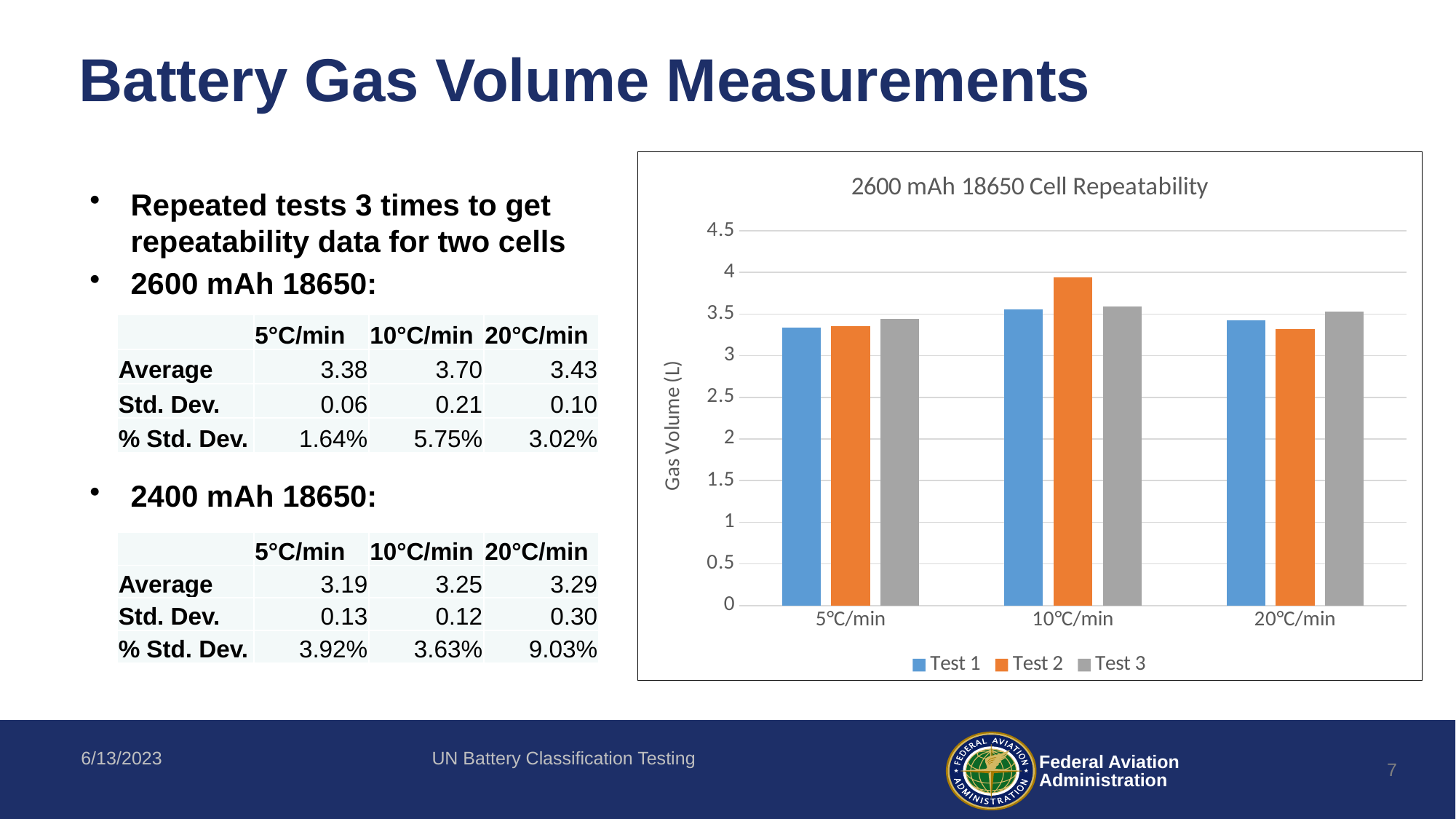
Is the Test 2 value at 20°C/min greater or less than 3.5? less Is the Test 1 value at 5°C/min greater or less than 3.5? less What is the label of the vertical axis of the chart? Gas Volume (L) Which series has the tallest bar in the chart, and at which heating rate? Test 2 at 10°C/min How many series does the chart legend list? 3 What is the title of the chart? 2600 mAh 18650 Cell Repeatability Is the Test 2 value at 10°C/min greater or less than 3.5? greater What type of chart is shown on the slide? bar chart At 10°C/min, which is larger: the Test 1 value or the Test 2 value? Test 2 How many heating-rate categories are shown on the x axis of the chart? 3 At 20°C/min, which is larger: the Test 2 value or the Test 3 value? Test 3